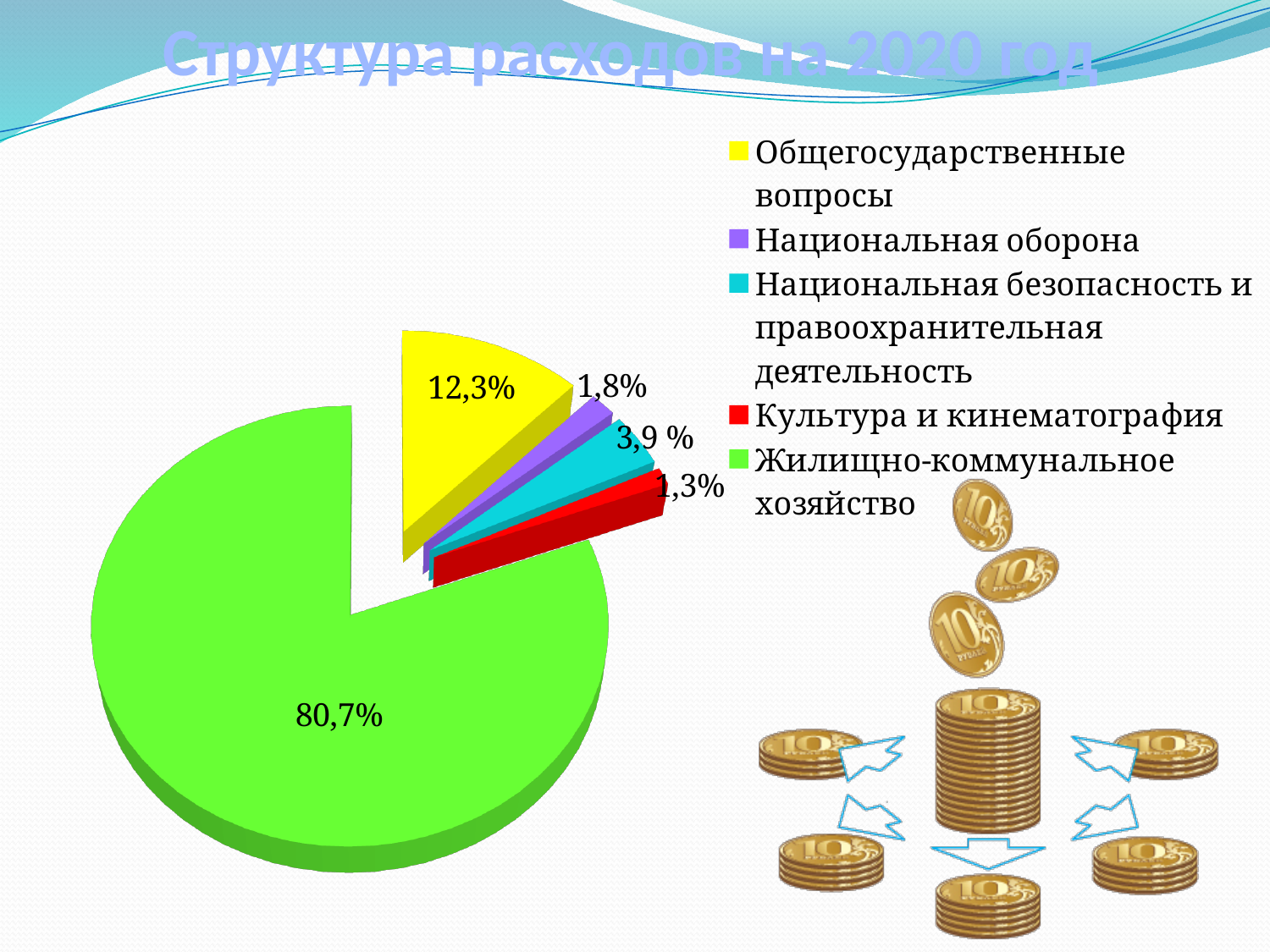
What share of expenditures goes to Жилищно-коммунальное хозяйство? 80,7% What colour is the slice for Общегосударственные вопросы? yellow What share of expenditures goes to Национальная безопасность и правоохранительная деятельность? 3,9 % Which is larger: the share for Национальная оборона or for Национальная безопасность и правоохранительная деятельность? Национальная безопасность и правоохранительная деятельность How many categories does the legend list? 5 What kind of chart is shown on the slide? pie chart What is the title of the chart? Структура расходов на 2020 год What share of expenditures goes to Национальная оборона? 1,8% Which category has the smallest share of expenditures? Культура и кинематография What share of expenditures goes to Культура и кинематография? 1,3% What share of expenditures goes to Общегосударственные вопросы? 12,3% Which category has the largest share of expenditures? Жилищно-коммунальное хозяйство